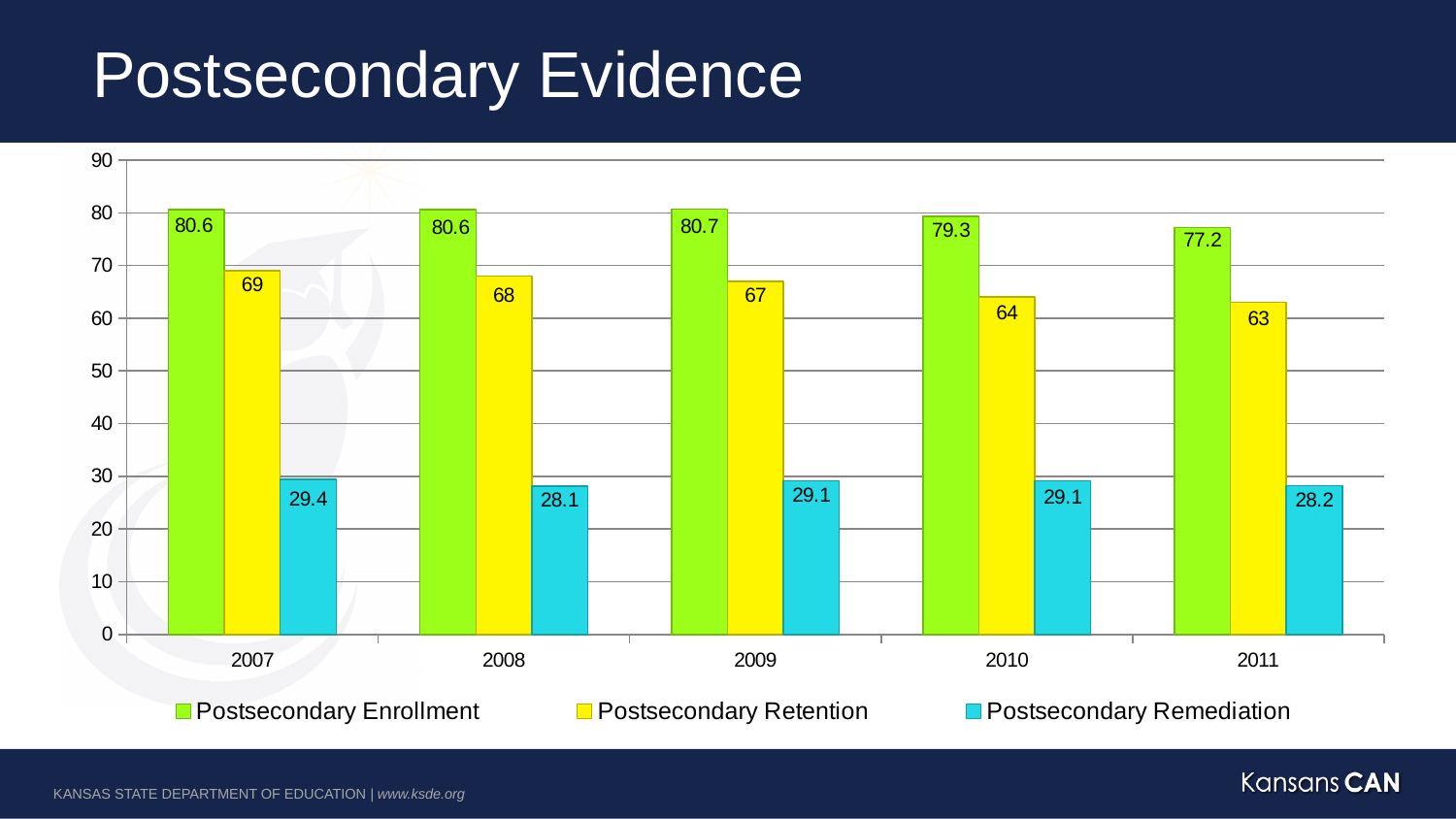
Is the Postsecondary Enrollment value for 2010 greater or less than 70? greater Does Postsecondary Retention rise or fall from 2007 to 2011? Fall How many series does the legend list? 3 What kind of chart is shown on the slide? Bar chart What is the Postsecondary Enrollment value for 2009? 80.7 Which year has the lowest Postsecondary Retention value? 2011 What is the difference between Postsecondary Enrollment and Postsecondary Retention in 2011? 14.2 Which year has the highest Postsecondary Enrollment value? 2009 What is the Postsecondary Remediation value for 2007? 29.4 How many years are shown on the x axis? 5 Is the Postsecondary Remediation value for 2008 larger than the value for 2011? No What is the Postsecondary Retention value for 2010? 64